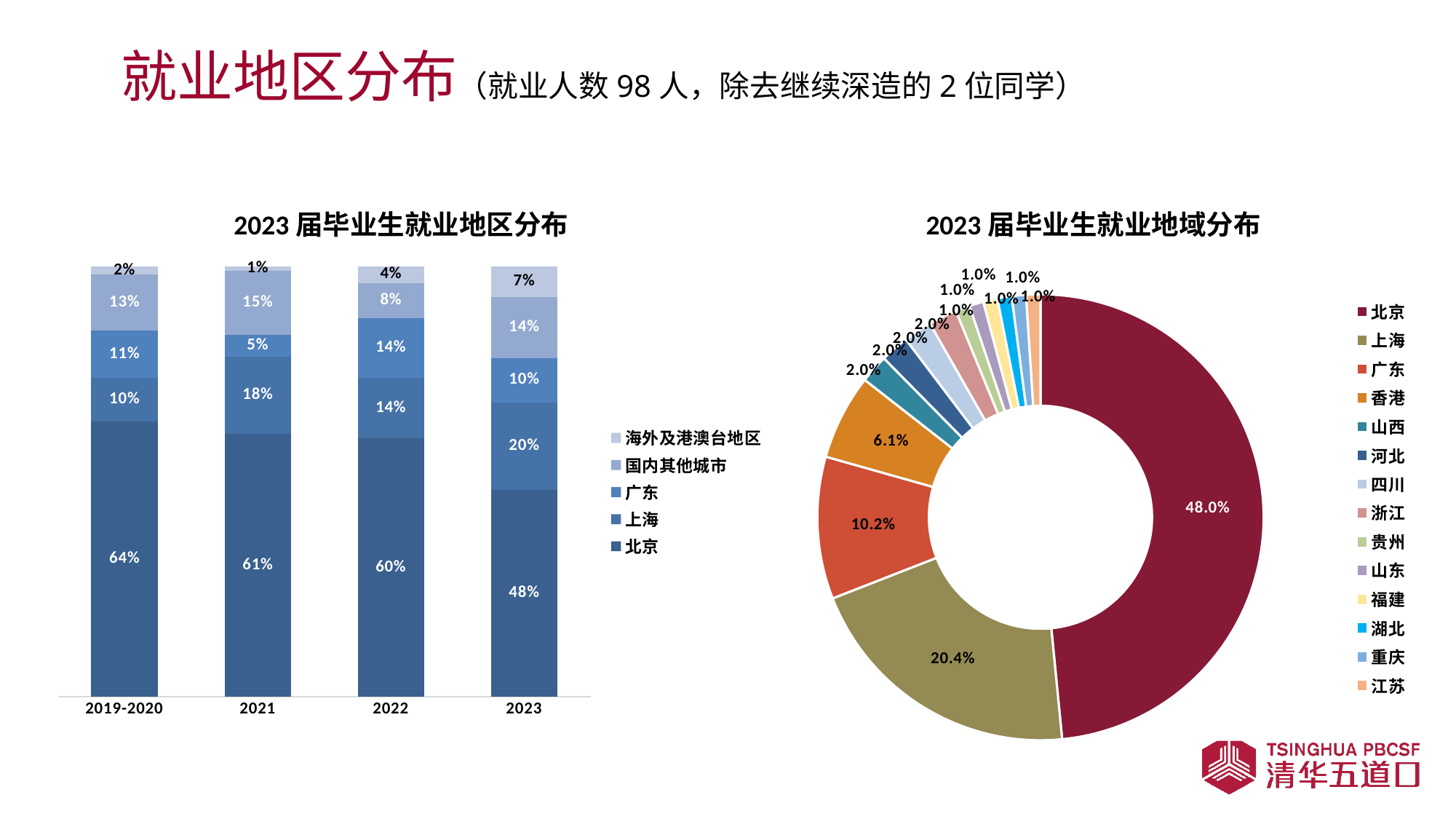
In the stacked bar chart on the left, what is the value for 海外及港澳台地区 in 2022? 4% In the donut chart on the right, which region has the largest share? 北京 In the stacked bar chart on the left, how many years are shown on the x axis? 4 In the stacked bar chart on the left, which year has the lowest value for 北京? 2023 In the donut chart on the right, how many regions does the legend list? 14 In the stacked bar chart on the left, what is the difference between the 北京 value in 2019-2020 and in 2023? 16% In the donut chart on the right, what share does 上海 have? 20.4% In the stacked bar chart on the left, how many series does the legend list? 5 In the stacked bar chart on the left, does 北京 rise or fall from 2019-2020 to 2023? fall In the donut chart on the right, what is the value for 香港? 6.1% In the stacked bar chart on the left, what is the value for 北京 in 2023? 48% In the stacked bar chart on the left, what is the value for 上海 in 2021? 18%